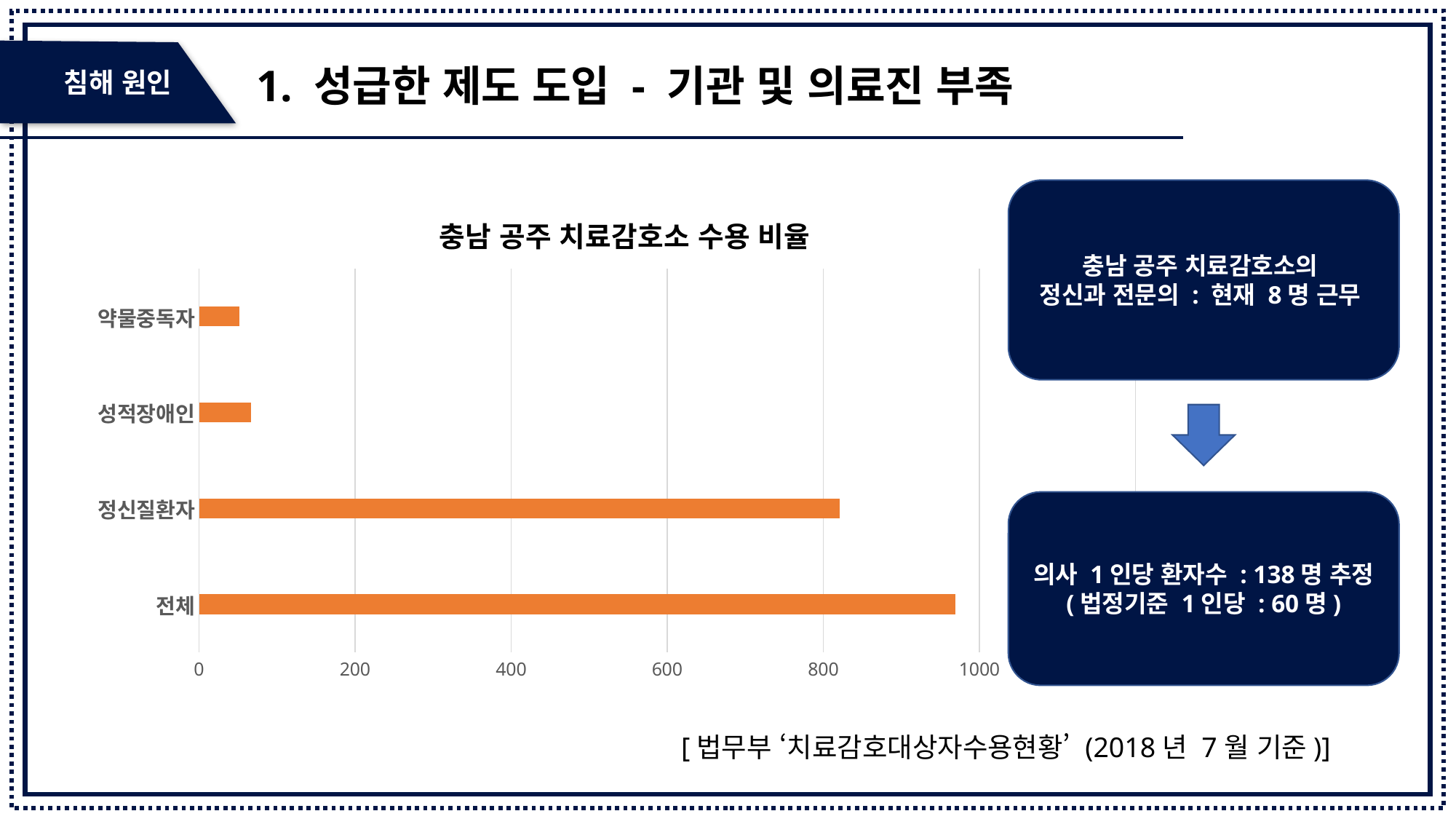
Is the value for 정신질환자 greater or less than 800? greater What kind of chart is shown on the slide? bar chart What is the title of the chart? 충남 공주 치료감호소 수용 비율 Is the value for 성적장애인 greater or less than 200? less How many categories are plotted in the chart? 4 Which is larger, the value for 성적장애인 or the value for 정신질환자? 정신질환자 Which is larger, the value for 정신질환자 or the value for 전체? 전체 What is the highest value shown on the horizontal axis of the chart? 1000 Is the value for 전체 greater or less than 800? greater Which category has the highest value in the chart? 전체